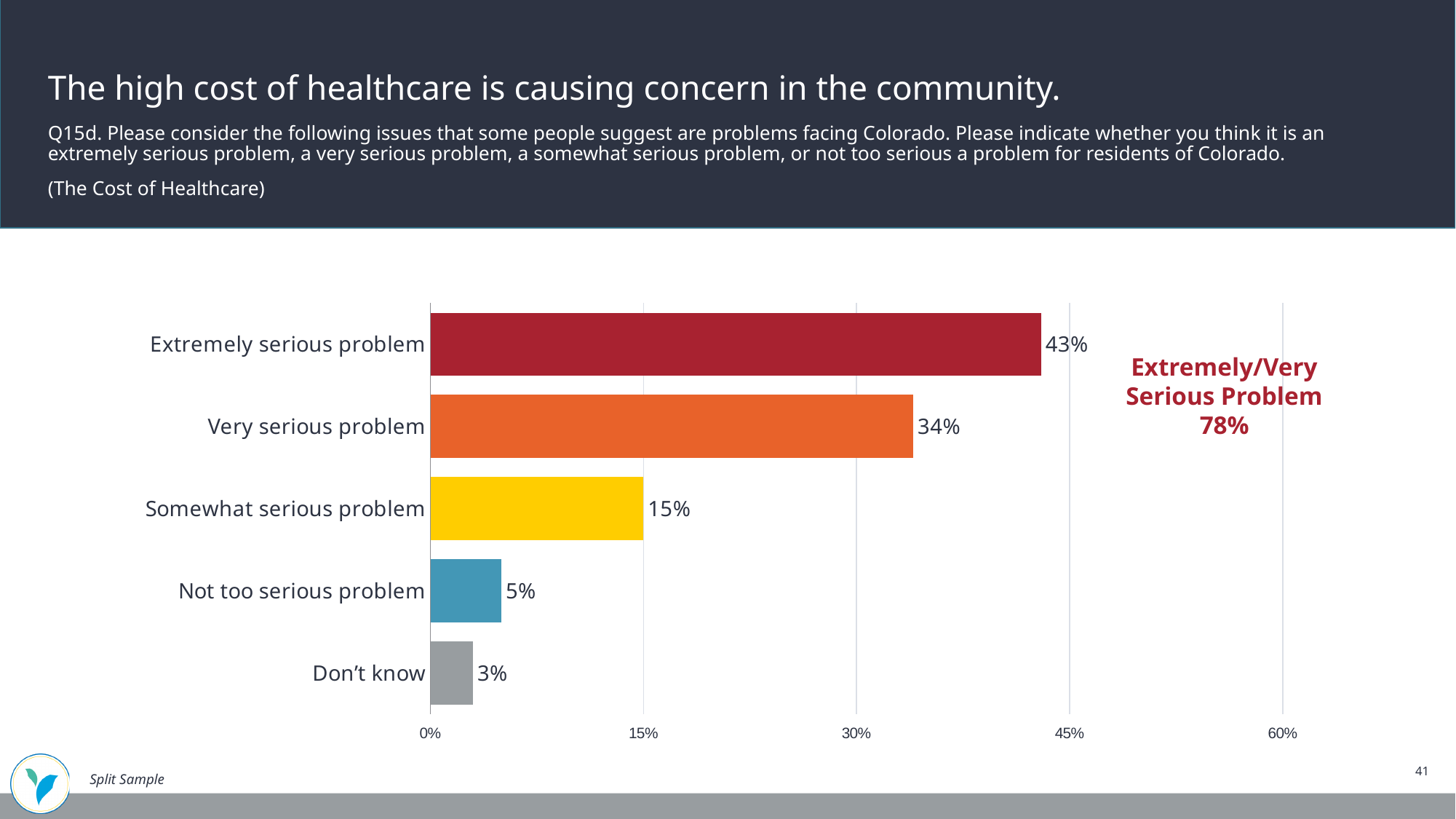
Which response category has the lowest percentage? Don't know What is the difference in percentage points between 'Extremely serious problem' and 'Very serious problem'? 9 How many response categories are shown in the chart? 5 What percentage of respondents answered 'Don't know'? 3% What kind of chart is shown on the slide? Bar chart Which response category has the highest percentage? Extremely serious problem What percentage of respondents said the cost of healthcare is a very serious problem? 34% What combined percentage is shown for 'Extremely/Very Serious Problem'? 78% Is the value for 'Very serious problem' greater or less than 30%? greater What percentage of respondents said the cost of healthcare is an extremely serious problem? 43% Which is larger: the value for 'Somewhat serious problem' or the value for 'Not too serious problem'? Somewhat serious problem What is the highest value shown on the x axis of the chart? 60%